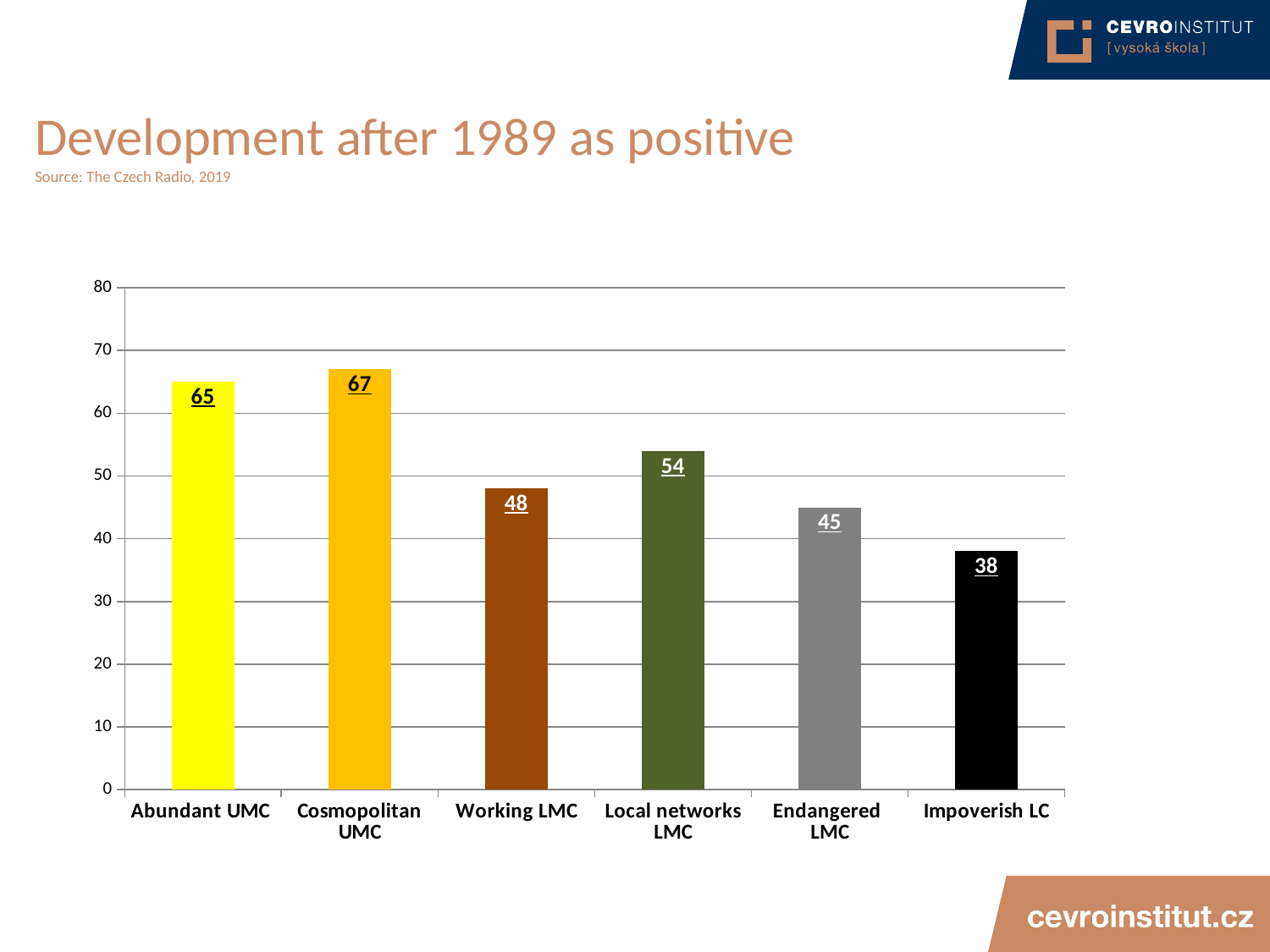
Is the value for Endangered LMC greater or less than 50? less Do the values generally rise or fall from left to right along the x axis? fall What is the value for Impoverish LC? 38 What is the title of the slide containing the chart? Development after 1989 as positive Which category has the lowest value? Impoverish LC Which is larger, the value for Working LMC or the value for Endangered LMC? Working LMC How many categories are shown on the x axis? 6 What is the value for Abundant UMC? 65 What kind of chart is shown on the slide? bar chart What is the difference between the values for Cosmopolitan UMC and Working LMC? 19 What is the value for Local networks LMC? 54 Which category has the highest value? Cosmopolitan UMC